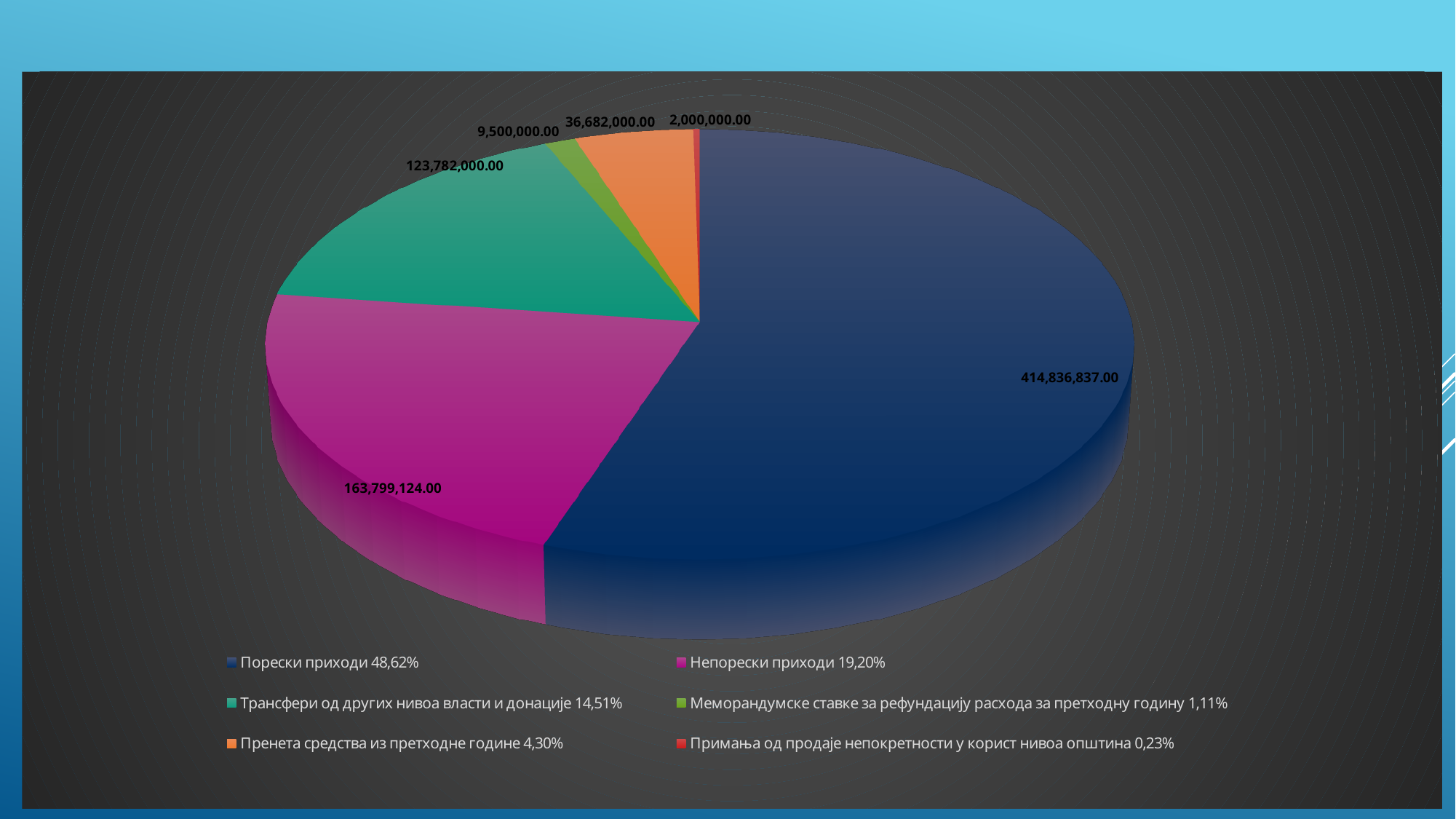
Which is larger: the Непорески приходи slice or the Трансфери од других нивоа власти и донације slice? Непорески приходи Which category has the smallest slice of the pie? Примања од продаје непокретности у корист нивоа општина How many slices does the pie chart have? 6 What is the value of the Трансфери од других нивоа власти и донације slice? 123,782,000.00 According to the legend, what share of the pie does Порески приходи represent? 48,62% What is the value of the Пренета средства из претходне године slice? 36,682,000.00 What kind of chart is shown on the slide? Pie chart What is the value of the Непорески приходи slice? 163,799,124.00 What is the difference between the Пренета средства из претходне године value and the Меморандумске ставке за рефундацију расхода за претходну годину value? 27,182,000.00 What is the value of the Порески приходи slice? 414,836,837.00 Which category has the largest slice of the pie? Порески приходи What is the difference between the Порески приходи value and the Непорески приходи value? 251,037,713.00